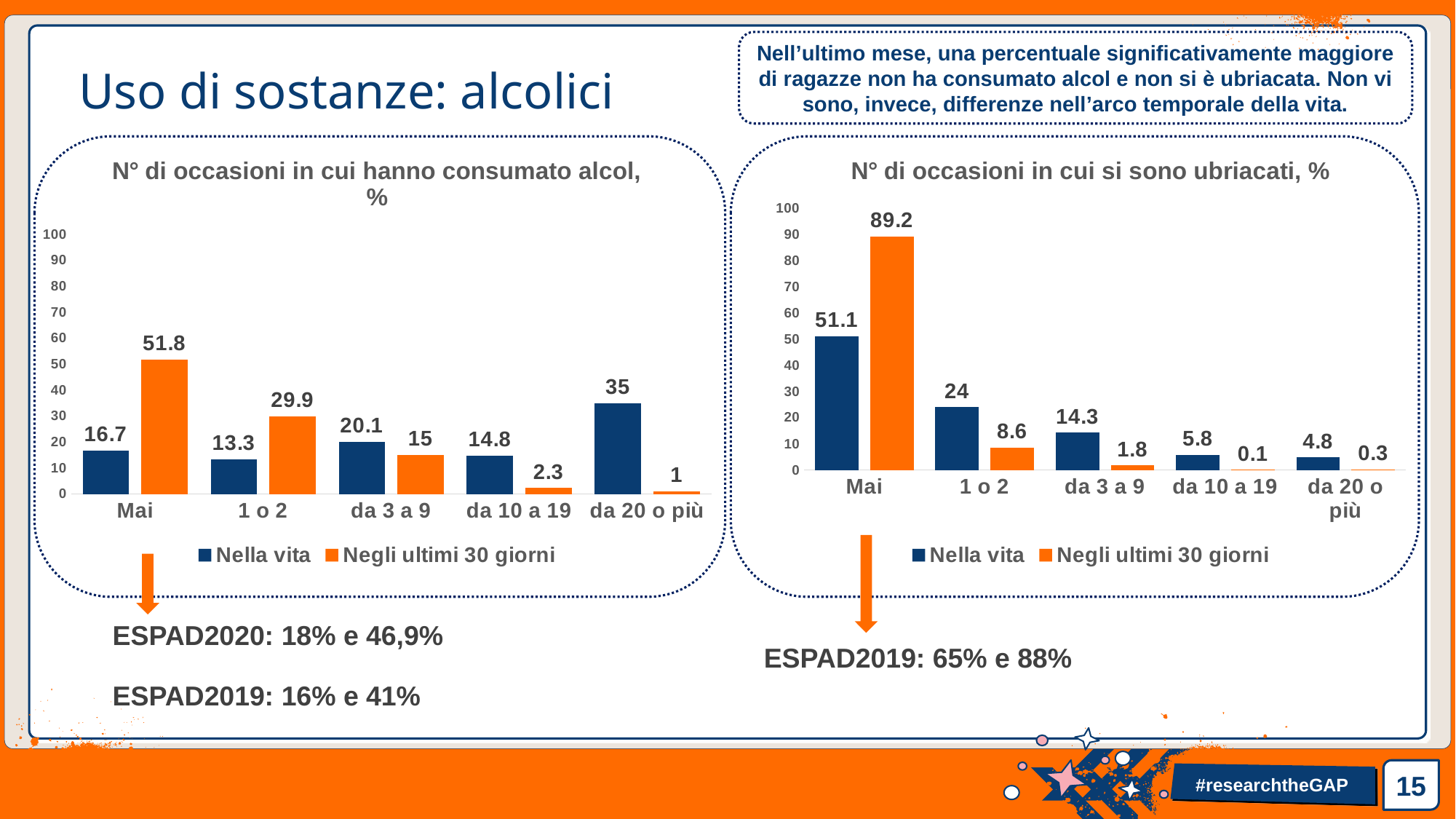
In the chart 'N° di occasioni in cui si sono ubriacati, %', what is the value for 'Negli ultimi 30 giorni' in the 'Mai' category? 89.2 In the chart 'N° di occasioni in cui si sono ubriacati, %', which is larger for 'da 3 a 9': 'Nella vita' or 'Negli ultimi 30 giorni'? Nella vita How many series does the legend of the chart 'N° di occasioni in cui si sono ubriacati, %' list? 2 In the chart 'N° di occasioni in cui hanno consumato alcol, %', which colour represents the 'Negli ultimi 30 giorni' series? Orange In the chart 'N° di occasioni in cui hanno consumato alcol, %', what is the value for 'Negli ultimi 30 giorni' in the 'Mai' category? 51.8 How many categories are shown on the x axis of the chart 'N° di occasioni in cui hanno consumato alcol, %'? 5 In the chart 'N° di occasioni in cui hanno consumato alcol, %', which category has the highest 'Nella vita' value? da 20 o più In the chart 'N° di occasioni in cui hanno consumato alcol, %', what is the difference between the 'Negli ultimi 30 giorni' and 'Nella vita' values for 'Mai'? 35.1 In the chart 'N° di occasioni in cui hanno consumato alcol, %', what is the value for 'Nella vita' in the 'da 20 o più' category? 35 In the chart 'N° di occasioni in cui si sono ubriacati, %', what is the value for 'Nella vita' in the '1 o 2' category? 24 In the chart 'N° di occasioni in cui si sono ubriacati, %', which category has the lowest 'Negli ultimi 30 giorni' value? da 10 a 19 What kind of chart is 'N° di occasioni in cui si sono ubriacati, %'? Bar chart